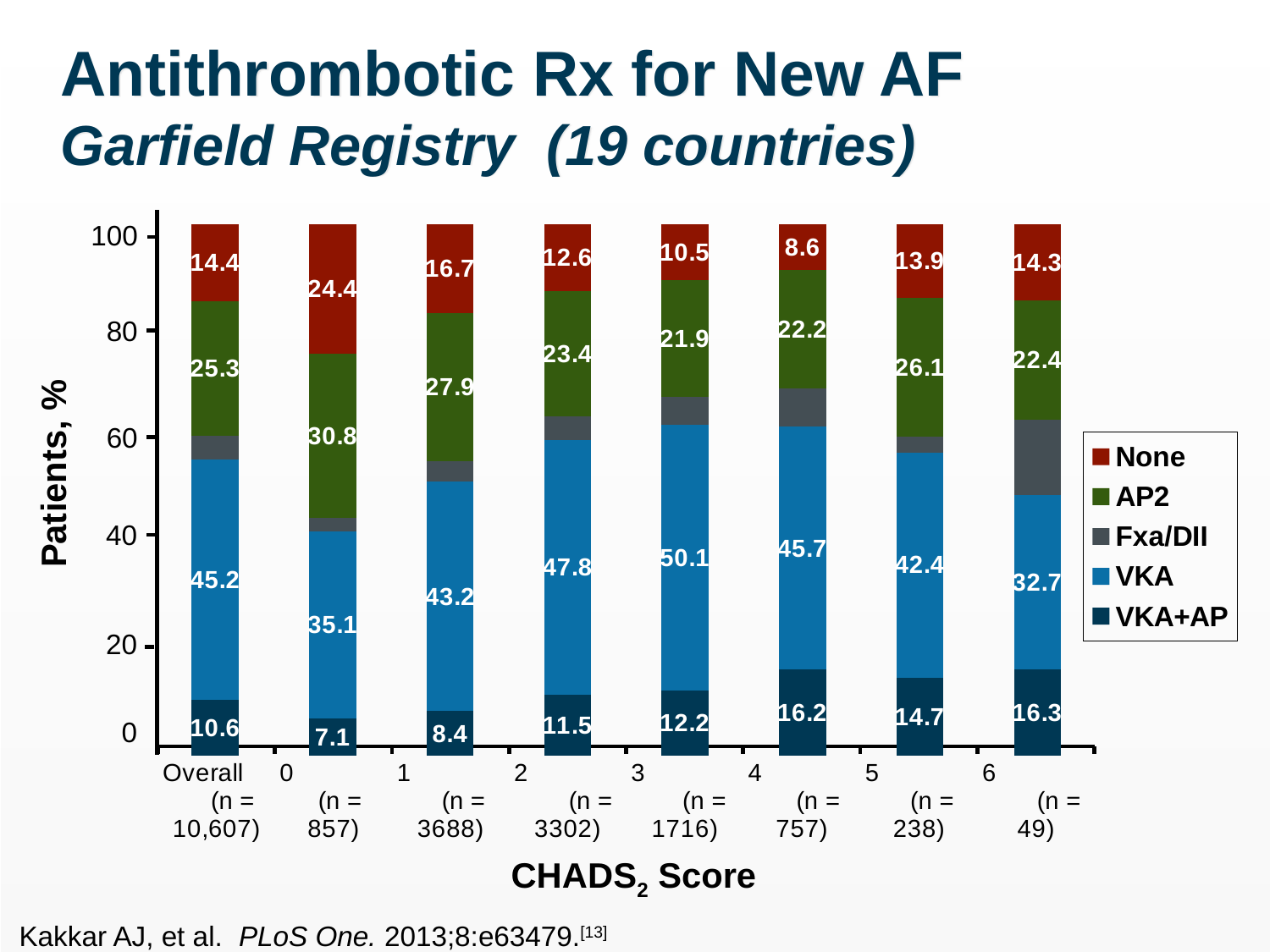
How many groups (bars) are shown on the x axis? 8 What is the AP2 value for patients with a CHADS2 score of 1? 27.9 Which CHADS2 score group has the lowest VKA value? 6 How many series does the legend list? 5 Which group has the highest VKA value? 3 What is the VKA value for the Overall group? 45.2 What percentage of patients with a CHADS2 score of 0 received no antithrombotic therapy (None)? 24.4 Which CHADS2 score group has the highest None value? 0 Is the AP2 value larger for CHADS2 score 0 or CHADS2 score 4? CHADS2 score 0 What is the difference between the VKA value for CHADS2 score 3 and the VKA value for CHADS2 score 0? 15.0 What is the VKA+AP value for patients with a CHADS2 score of 6? 16.3 What kind of chart is shown on the slide? Stacked bar chart